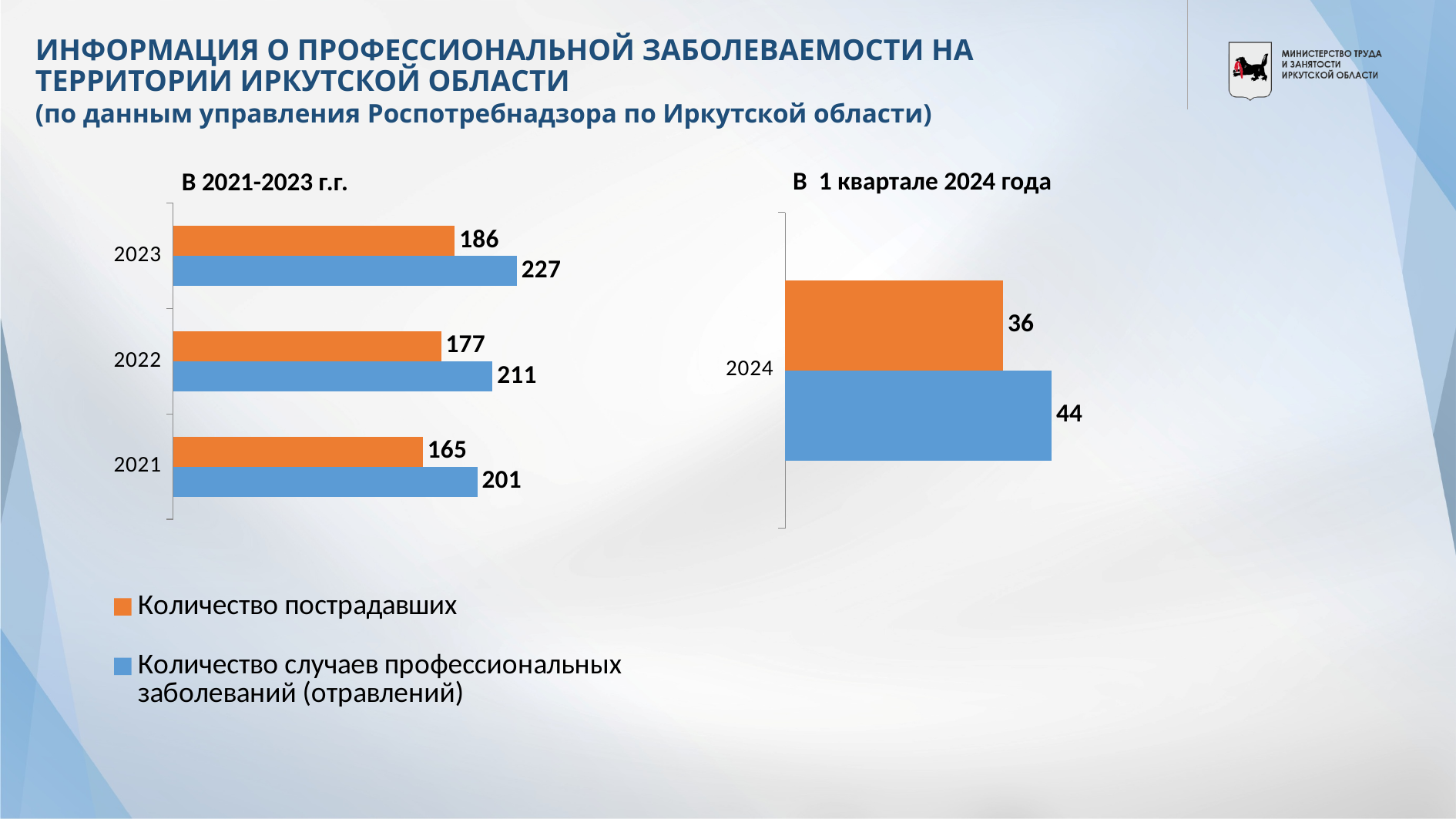
How many series does the legend list? 2 In the chart 'В 2021-2023 г.г.', what is the value of 'Количество пострадавших' for 2023? 186 In the chart 'В 2021-2023 г.г.', what is the difference between 'Количество случаев профессиональных заболеваний (отравлений)' and 'Количество пострадавших' in 2022? 34 In the chart 'В 2021-2023 г.г.', does 'Количество случаев профессиональных заболеваний (отравлений)' rise or fall from 2021 to 2023? rise In the chart 'В 2021-2023 г.г.', which year has the lowest value of 'Количество пострадавших'? 2021 In the chart 'В 2021-2023 г.г.', which year has the highest value of 'Количество случаев профессиональных заболеваний (отравлений)'? 2023 In the chart 'В 2021-2023 г.г.', what is the value of 'Количество случаев профессиональных заболеваний (отравлений)' for 2021? 201 In the chart 'В 1 квартале 2024 года', what is the value of 'Количество случаев профессиональных заболеваний (отравлений)' for 2024? 44 In the chart 'В 2021-2023 г.г.', which is larger: 'Количество пострадавших' in 2023 or 'Количество пострадавших' in 2022? 2023 In the chart 'В 2021-2023 г.г.', how many years are shown? 3 What type of chart is 'В 2021-2023 г.г.'? bar chart In the chart 'В 1 квартале 2024 года', what is the value of 'Количество пострадавших' for 2024? 36